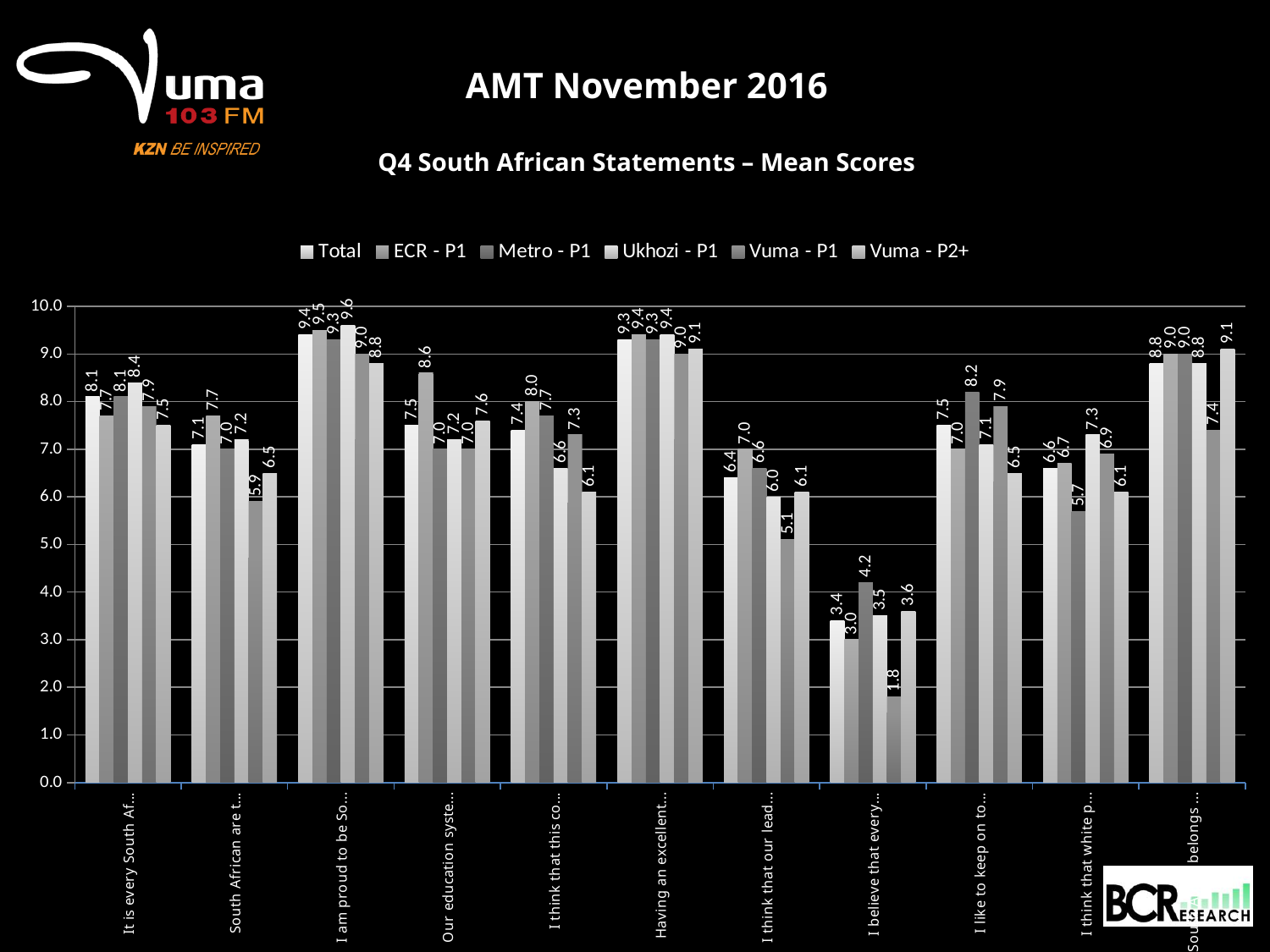
What is the difference between the Ukhozi - P1 and Vuma - P2+ values for the statement labelled "I am proud to be So..."? 0.8 Which series has the lowest value for the statement labelled "I think that our lead..."? Vuma - P1 How many series does the legend list? 6 What is the Vuma - P1 value for the statement labelled "I believe that every..."? 1.8 What kind of chart is shown on the slide? bar chart What is the ECR - P1 value for the statement labelled "Our education syste..."? 8.6 What is the Total value for the statement labelled "I am proud to be So..."? 9.4 What is the Vuma - P2+ value for the statement labelled "Having an excellent..."? 9.1 Which series has the highest value for the statement labelled "I like to keep on to..."? Metro - P1 Is the Vuma - P1 value for the statement labelled "South African are t..." greater or less than 6.0? less For the statement labelled "I think that white p...", which is larger: the Ukhozi - P1 value or the Metro - P1 value? Ukhozi - P1 What is the subtitle of the chart on the slide? Q4 South African Statements – Mean Scores